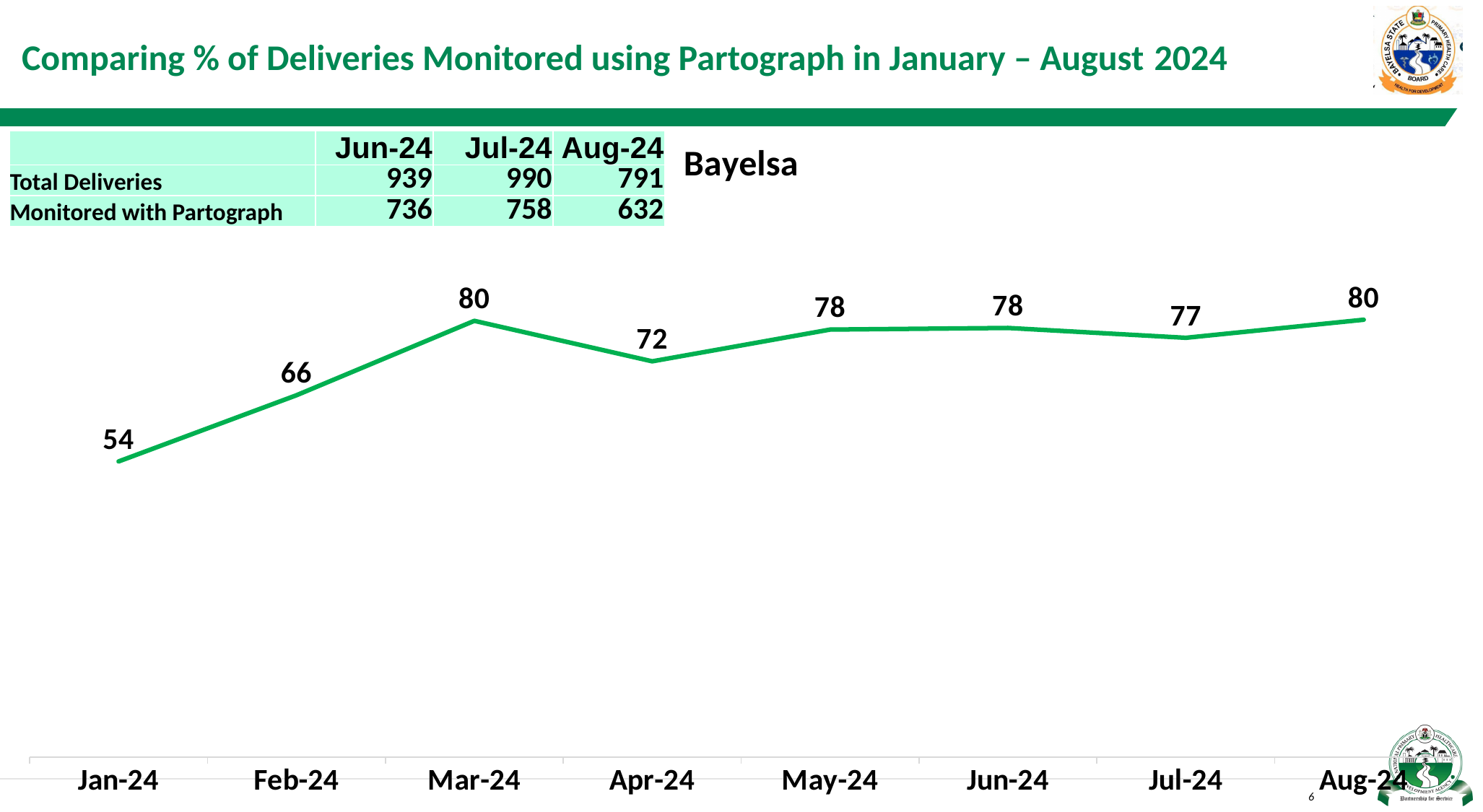
What is the value for Jul-24 on the Bayelsa line chart? 77 What is the title of the line chart on the slide? Bayelsa Which month has the lowest value on the Bayelsa line chart? Jan-24 What is the value for Feb-24 on the Bayelsa line chart? 66 Does the value on the Bayelsa line chart rise or fall from Jan-24 to Mar-24? Rise What is the value for Jan-24 on the Bayelsa line chart? 54 What is the difference between the values for Mar-24 and Apr-24 on the Bayelsa line chart? 8 What is the value for Apr-24 on the Bayelsa line chart? 72 What is the difference between the values for Feb-24 and Jan-24 on the Bayelsa line chart? 12 How many months are plotted on the Bayelsa line chart? 8 What kind of chart is shown on the slide? Line chart Which is larger on the Bayelsa line chart, the value for May-24 or the value for Apr-24? May-24